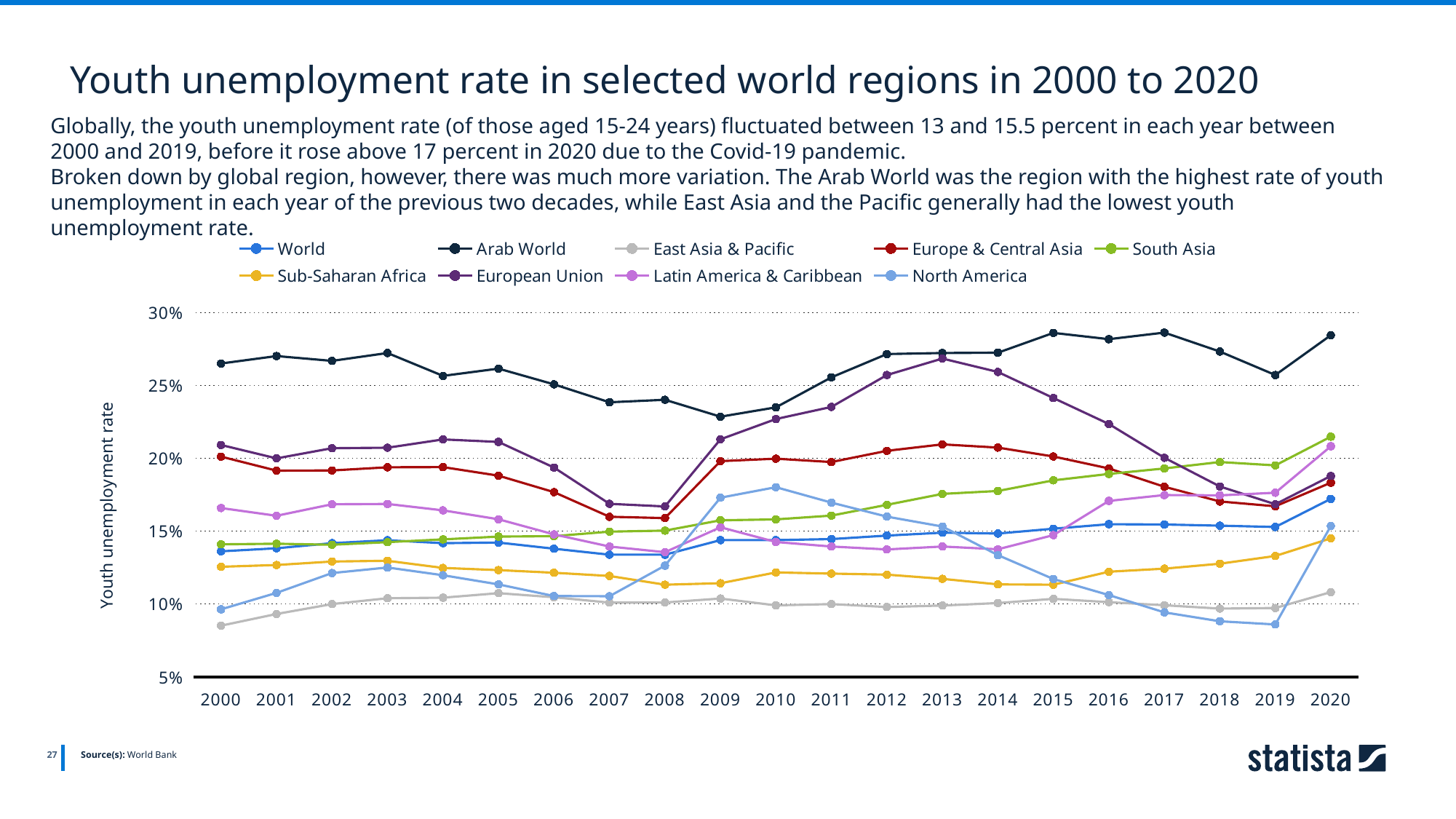
Which region has the lowest youth unemployment rate in 2010? East Asia & Pacific Which region has the highest youth unemployment rate in 2020? Arab World Is the value for North America in 2010 greater or less than 15%? greater Is the value for Arab World in 2009 greater or less than 25%? less Is the value for East Asia & Pacific in 2020 greater or less than 15%? less Does the European Union line rise or fall from 2013 to 2019? fall What is the title of the y axis? Youth unemployment rate In 2008, which is larger: the value for Arab World or the value for European Union? Arab World How many years are plotted along the x axis? 21 What kind of chart is shown on the slide? line chart How many series does the legend list? 9